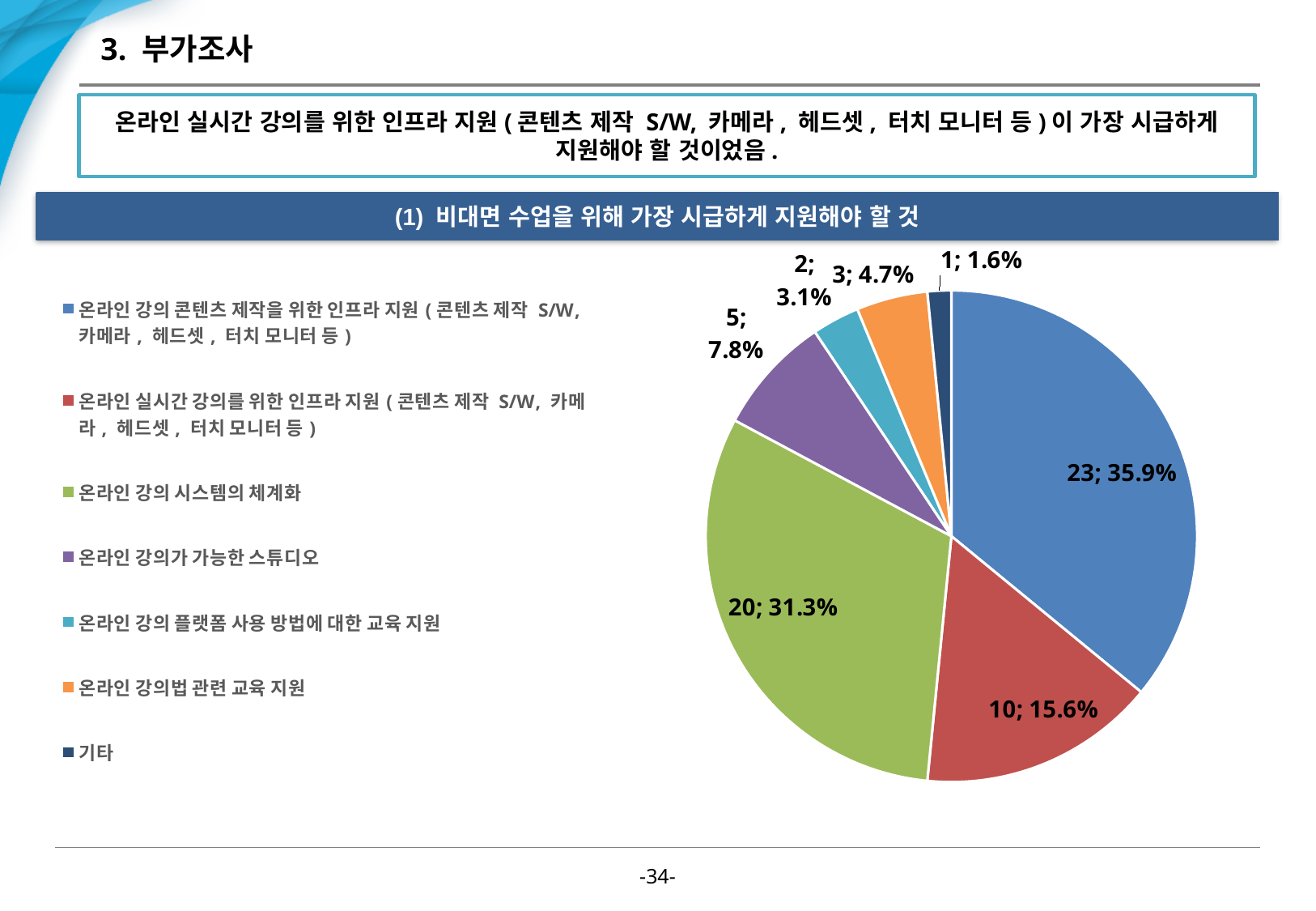
How many slices does the pie chart have? 7 Which category has the largest slice in the pie chart? 온라인 강의 콘텐츠 제작을 위한 인프라 지원 (콘텐츠 제작 S/W, 카메라, 헤드셋, 터치 모니터 등) Which category has the smallest slice in the pie chart? 기타 What is the title of the chart section on the slide? (1) 비대면 수업을 위해 가장 시급하게 지원해야 할 것 What is the count shown for 온라인 강의가 가능한 스튜디오? 5 What is the difference in count between 온라인 강의 콘텐츠 제작을 위한 인프라 지원 and 온라인 강의 시스템의 체계화? 3 What is the total count across all slices of the pie chart? 64 What kind of chart is shown on the slide? pie chart What percentage share does 온라인 실시간 강의를 위한 인프라 지원 have in the pie chart? 15.6% What is the count and share shown for 온라인 강의 시스템의 체계화? 20; 31.3% What percentage share is shown for 기타? 1.6% Which has a larger count: 온라인 강의법 관련 교육 지원 or 온라인 강의 플랫폼 사용 방법에 대한 교육 지원? 온라인 강의법 관련 교육 지원